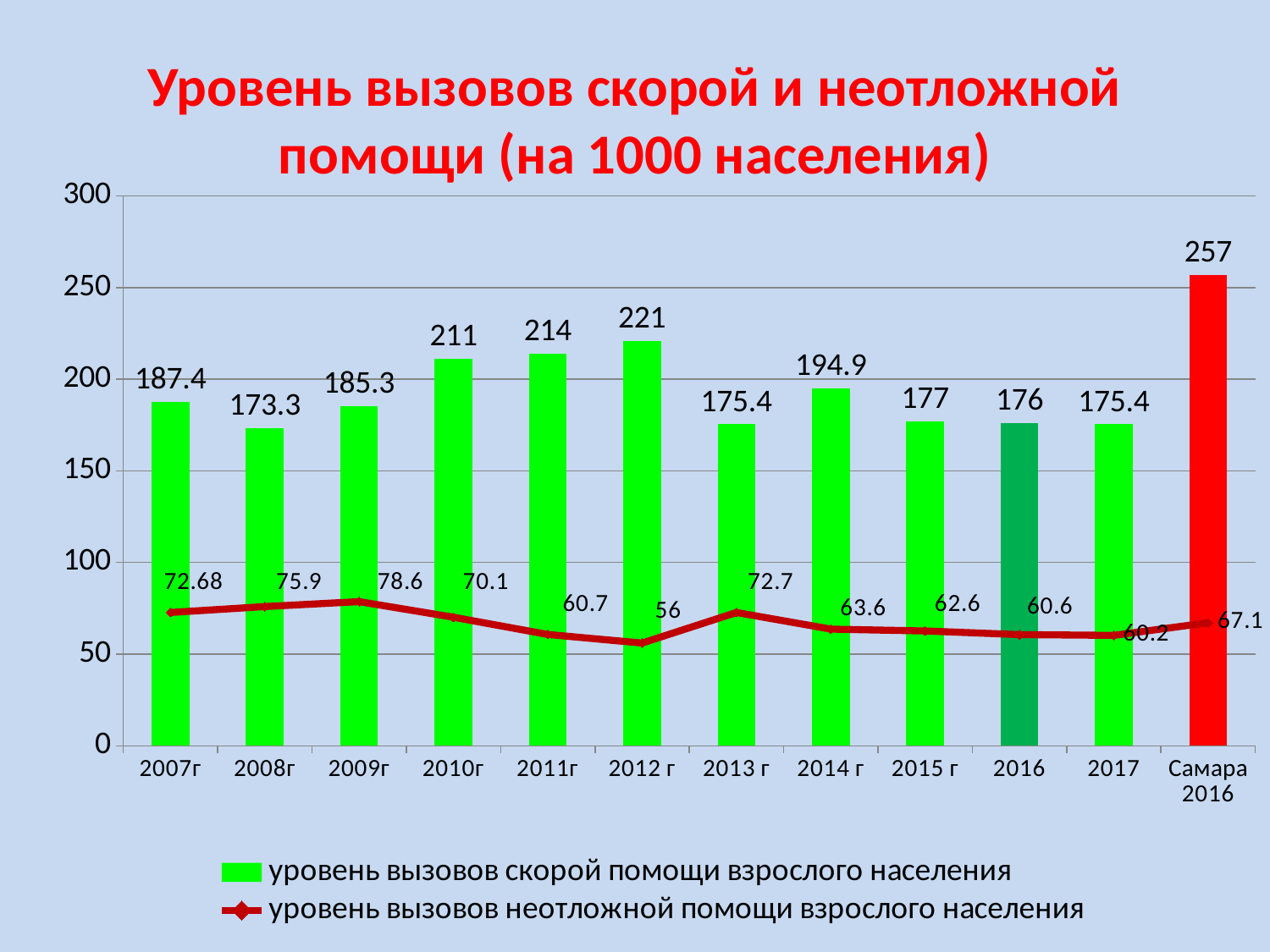
Which category has the lowest value on the line series (уровень вызовов неотложной помощи)? 2012 г What is the value of the line series (уровень вызовов неотложной помощи) for 2009г? 78.6 How many categories are shown on the x axis? 12 What is the difference between the bar values for 2012 г and 2013 г? 45.6 How many series does the legend list? 2 Which category has the highest bar value? Самара 2016 Which is larger: the bar value for 2010г or for 2014 г? 2010г What kind of chart is shown on the slide? Combined bar and line chart What is the value of the bar for 2012 г? 221 Do the bar values rise or fall from 2007г to 2008г? fall Is the bar value for 2008г greater or less than 200? less What colour is the bar for Самара 2016? Red